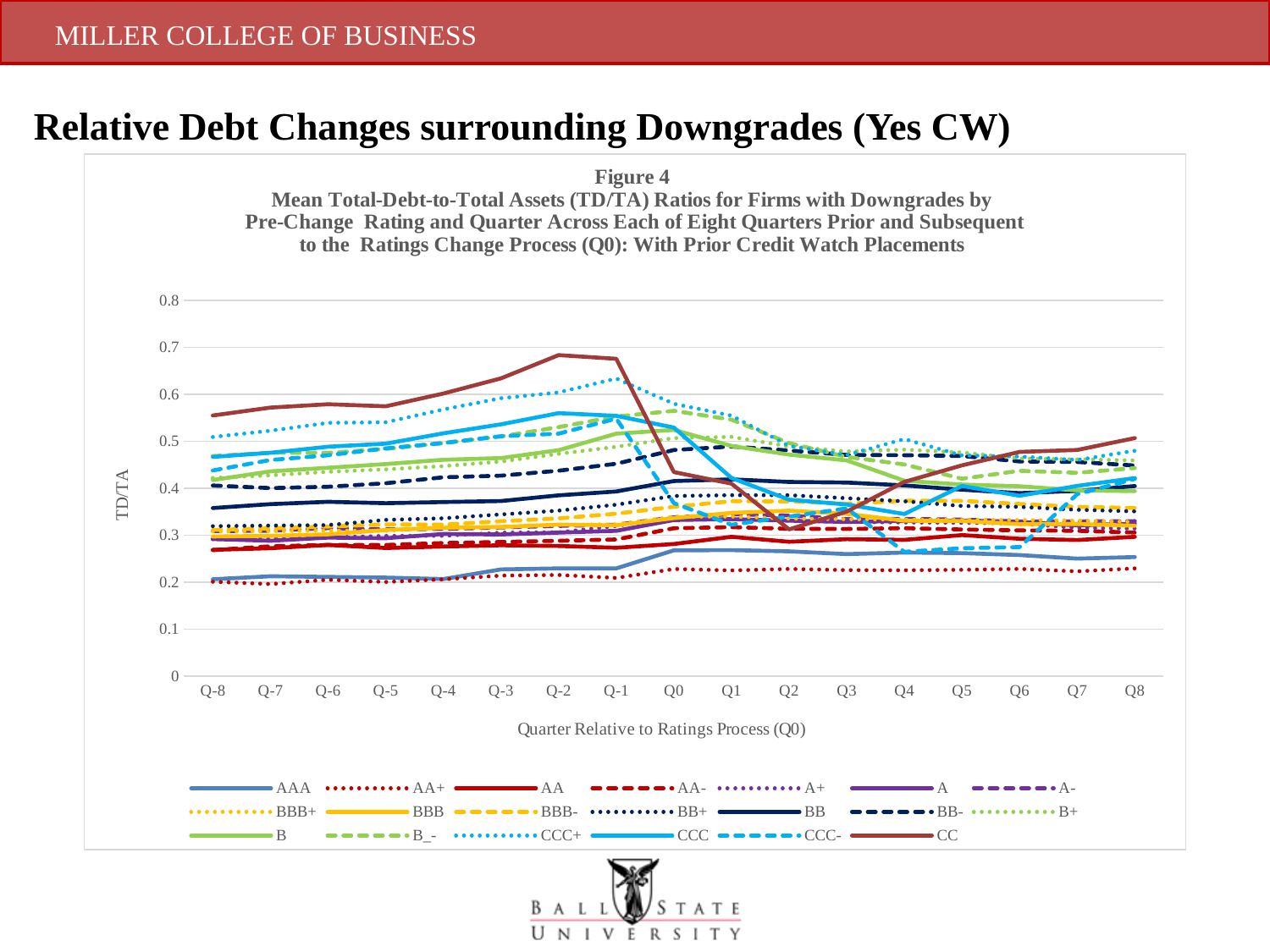
How many quarters are plotted along the x axis? 17 Is the value for the CC series at Q-2 greater or less than 0.6? greater What kind of chart is shown on the slide? line chart Does the CC series rise or fall from Q-2 to Q2? fall For the CC series, is the value at Q-2 or at Q2 larger? Q-2 What is the label of the y axis? TD/TA What is the label of the x axis? Quarter Relative to Ratings Process (Q0) Is the value for the AA+ series at Q8 greater or less than 0.3? less Is the value for the AAA series at Q-8 greater or less than 0.3? less Which series has the highest value at Q-2? CC How many series does the chart's legend list? 20